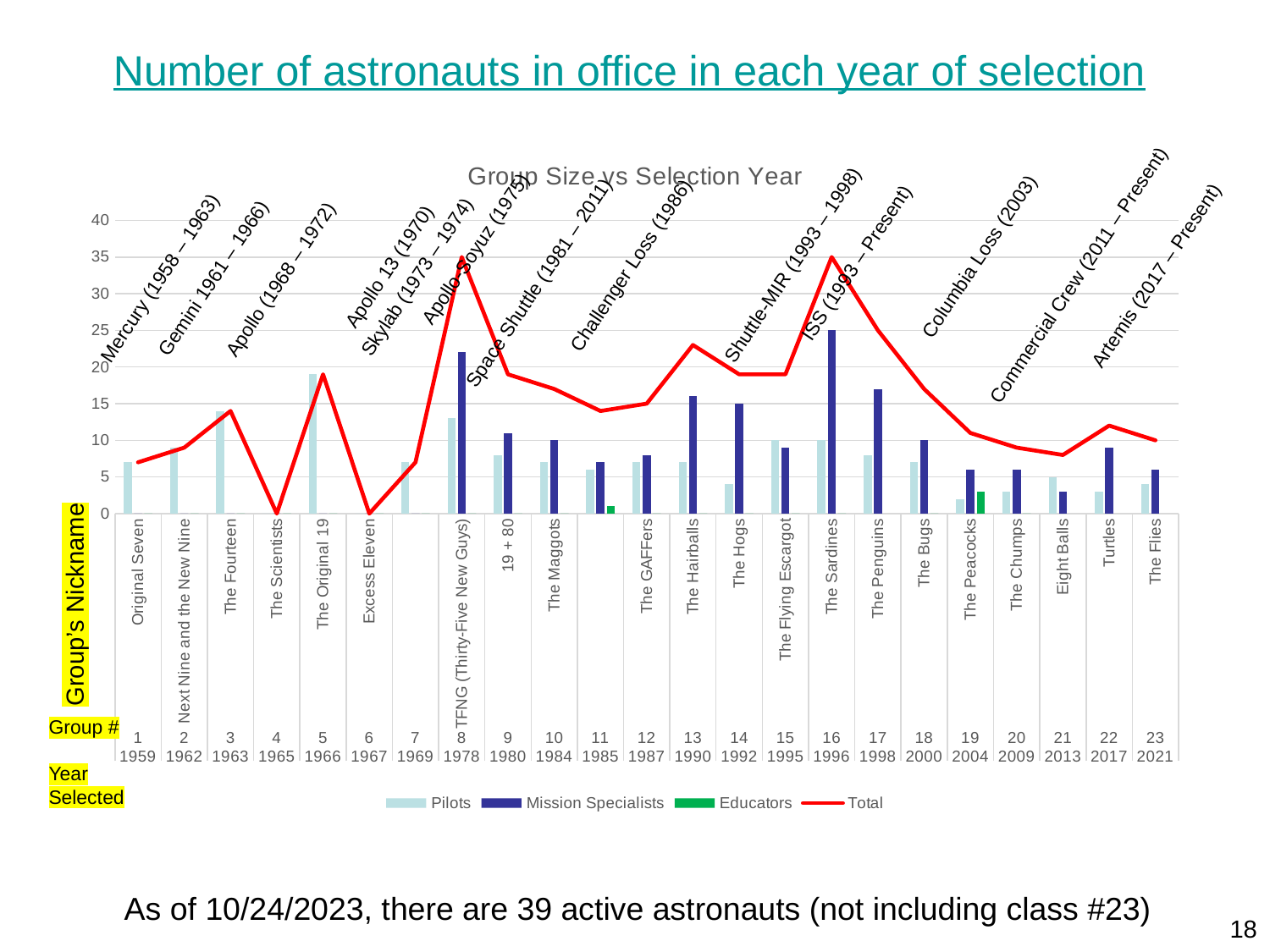
How many series does the chart legend list? 4 Which has the larger Mission Specialists value, The Sardines or The Penguins? The Sardines Is the Total value for The Peacocks greater or less than 15? less What is the Mission Specialists value for The Sardines? 25 What colour is the Total line? Red Is the Mission Specialists value for TFNG (Thirty-Five New Guys) greater or less than 20? greater What is the title of the chart? Group Size vs Selection Year Does the Total line rise or fall from 1996 to 2013? fall What is the Mission Specialists value for The Maggots? 10 Is the Pilots value for The Original 19 greater or less than 15? greater What kind of chart is this? Bar chart with a line How many astronaut groups are shown along the x axis? 23